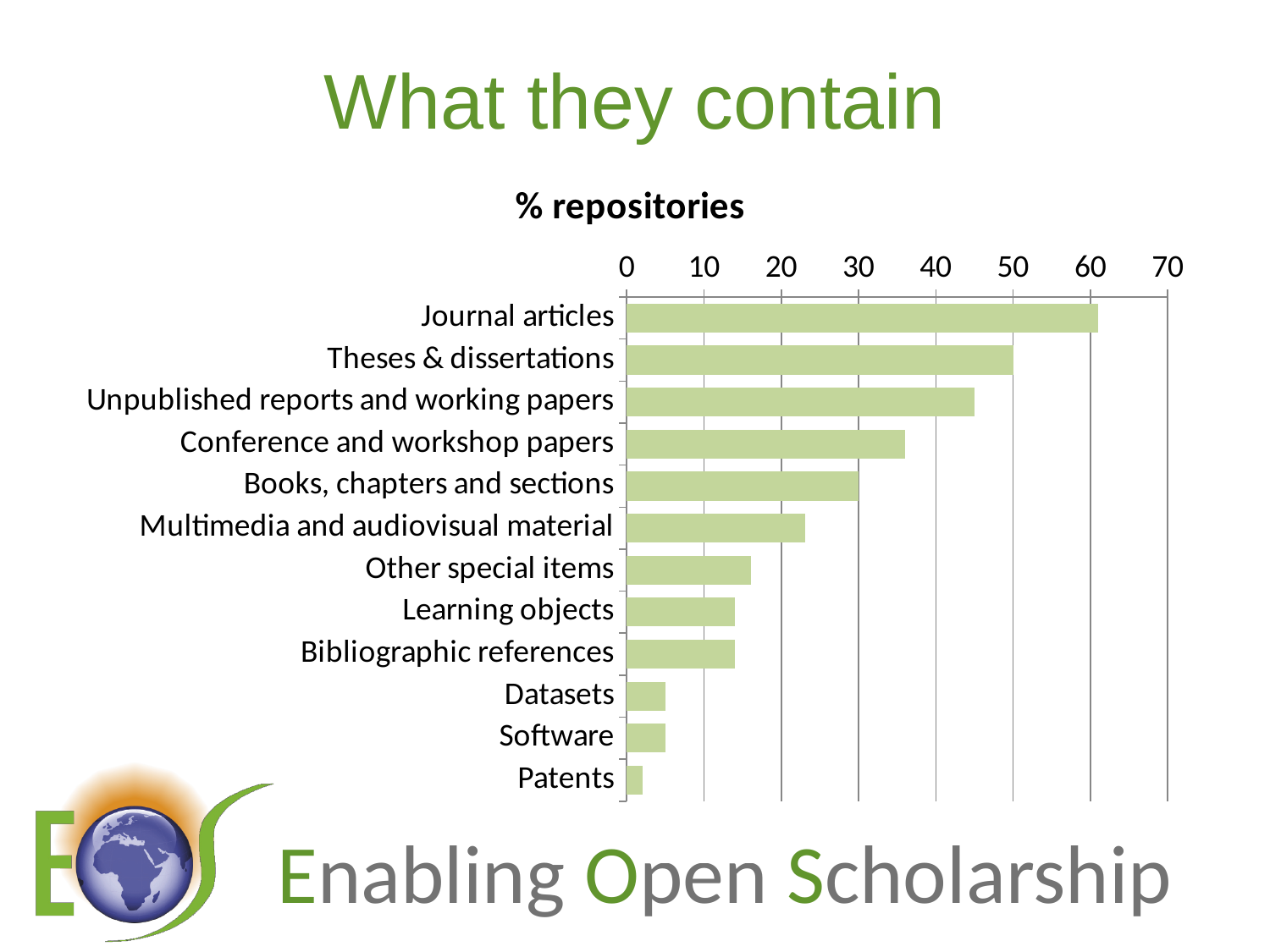
Which is larger, the value for Journal articles or the value for Theses & dissertations? Journal articles What is the title of the chart? % repositories What kind of chart is shown on the slide? bar chart How many categories are plotted in the chart? 12 Is the value for Unpublished reports and working papers greater or less than 40? greater Which category has the lowest value? Patents Is the value for Multimedia and audiovisual material greater or less than 20? greater Which category has the highest value? Journal articles Do the bar values increase or decrease going from the top category to the bottom category? decrease Is the value for Patents greater or less than 10? less Which is larger, the value for Conference and workshop papers or the value for Multimedia and audiovisual material? Conference and workshop papers